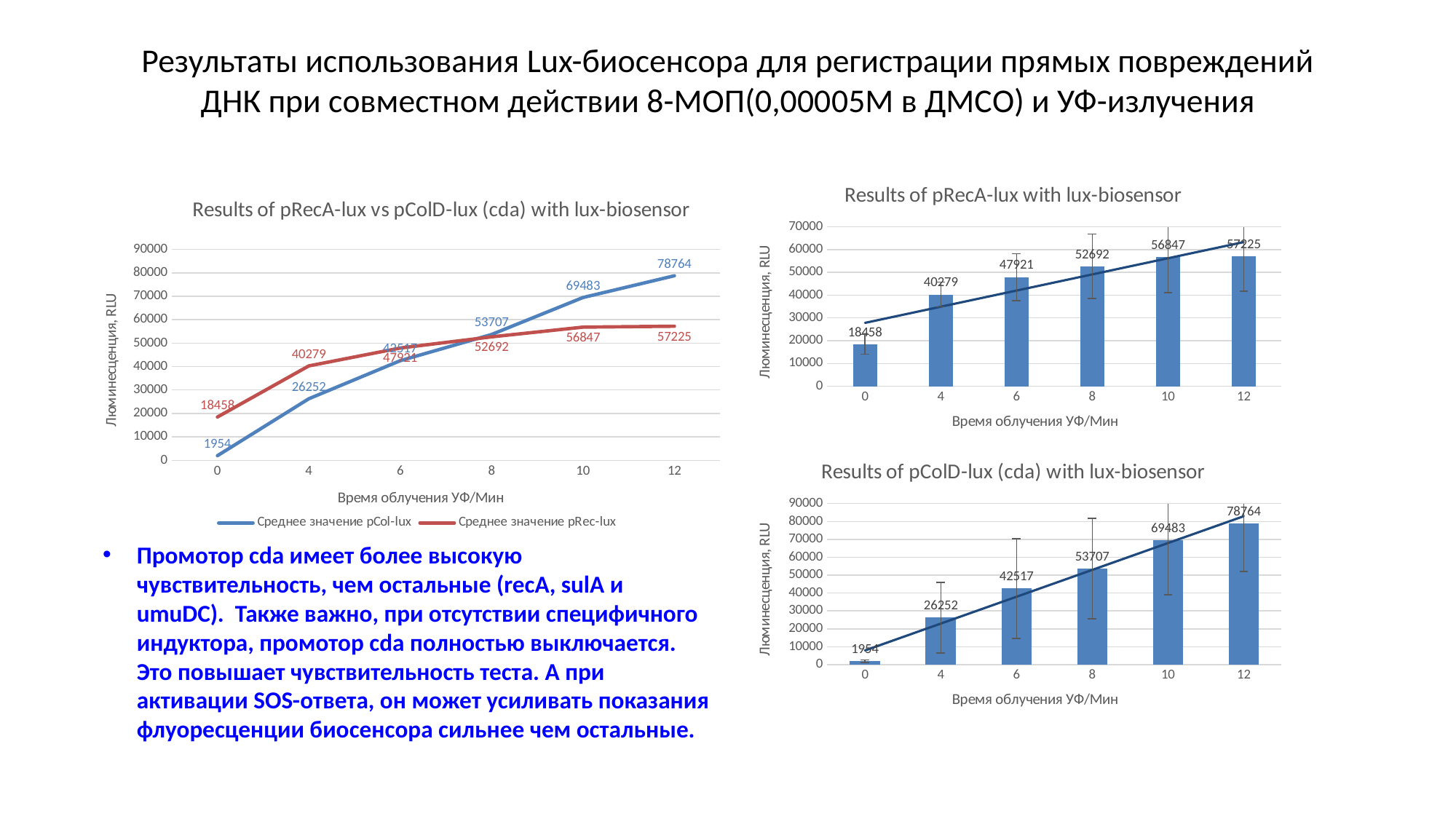
In the chart titled 'Results of pColD-lux (cda) with lux-biosensor', what is the luminescence value at 0 minutes? 1954 In the chart titled 'Results of pRecA-lux with lux-biosensor', which UV exposure time has the lowest luminescence? 0 In the chart titled 'Results of pColD-lux (cda) with lux-biosensor', what is the difference between the values at 12 minutes and 10 minutes? 9281 What type of chart is 'Results of pRecA-lux with lux-biosensor'? bar chart How many bars are shown in the chart titled 'Results of pColD-lux (cda) with lux-biosensor'? 6 In the chart titled 'Results of pRecA-lux vs pColD-lux (cda) with lux-biosensor', which series has the larger value at 4 minutes? Среднее значение pRec-lux In the chart titled 'Results of pRecA-lux with lux-biosensor', is the value at 8 minutes greater or less than 50000? greater In the chart titled 'Results of pRecA-lux with lux-biosensor', what is the luminescence value at 12 minutes of UV exposure? 57225 In the chart titled 'Results of pRecA-lux vs pColD-lux (cda) with lux-biosensor', which series has the larger value at 10 minutes? Среднее значение pCol-lux In the chart titled 'Results of pColD-lux (cda) with lux-biosensor', do the values rise or fall as UV exposure time increases? rise In the chart titled 'Results of pColD-lux (cda) with lux-biosensor', which UV exposure time has the highest luminescence? 12 How many series does the legend list in the chart titled 'Results of pRecA-lux vs pColD-lux (cda) with lux-biosensor'? 2